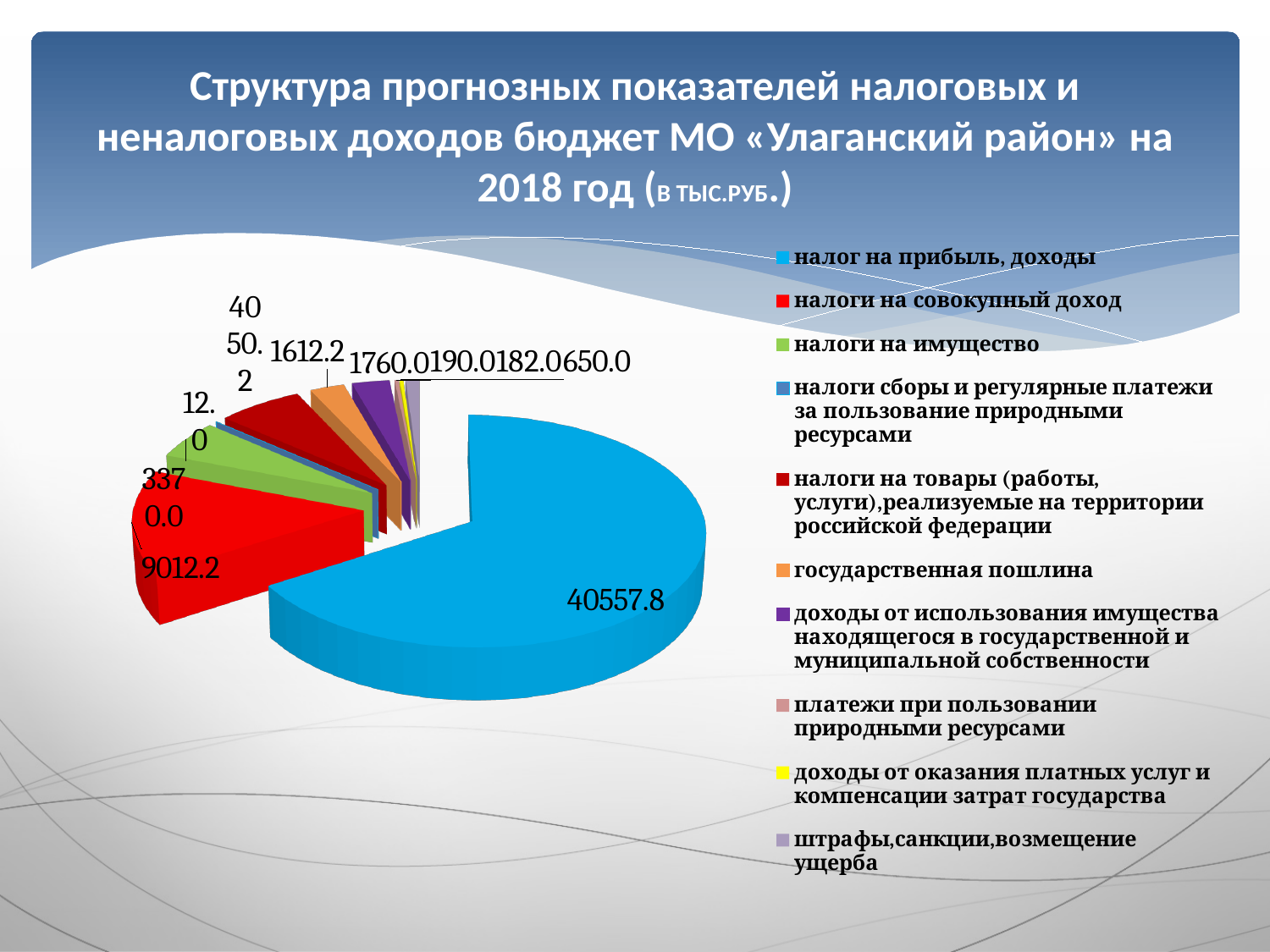
What is the value shown for налог на прибыль, доходы? 40557.8 How many categories does the legend of the pie chart list? 10 What is the value shown for налоги на совокупный доход? 9012.2 In what units are the values in the chart given, according to the title? тыс.руб. Which category has the largest slice in the pie chart? налог на прибыль, доходы What is the value shown for государственная пошлина? 1612.2 What kind of chart is shown on the slide? pie chart What is the difference between the values for налог на прибыль, доходы and налоги на совокупный доход? 31545.6 Which is larger: налоги на совокупный доход or государственная пошлина? налоги на совокупный доход Which is larger: налог на прибыль, доходы or налоги на совокупный доход? налог на прибыль, доходы What colour is the slice for налог на прибыль, доходы? light blue